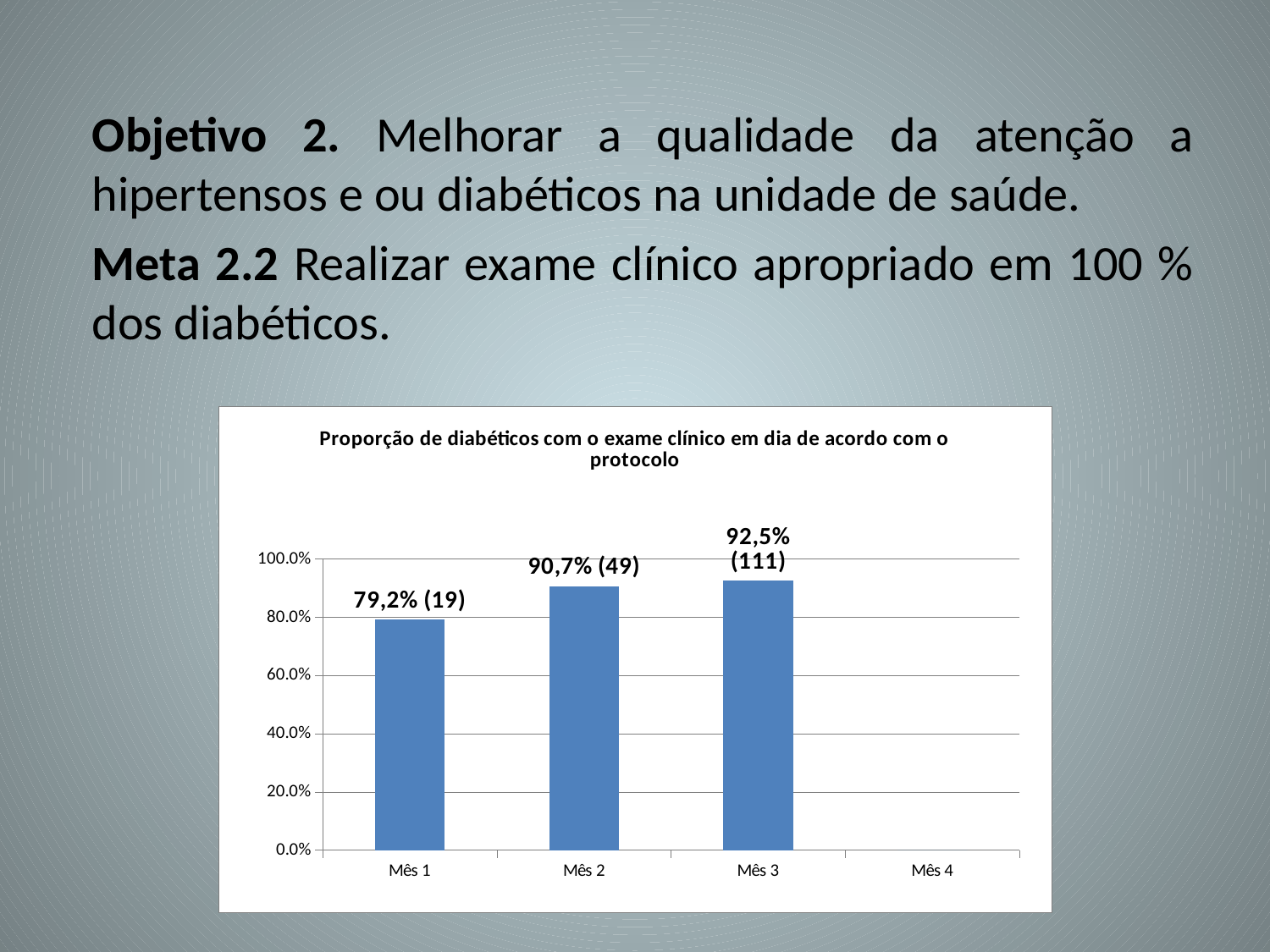
Which month has the highest proportion? Mês 3 Is the value for Mês 1 greater or less than 80.0%? less How many month categories are shown on the x axis? 4 What is the difference in percentage points between Mês 2 and Mês 1? 11,5 What is the title of the chart? Proporção de diabéticos com o exame clínico em dia de acordo com o protocolo Which month with a plotted bar has the lowest proportion? Mês 1 What is the value shown for Mês 1? 79,2% (19) What is the value shown for Mês 2? 90,7% (49) What kind of chart is shown on the slide? bar chart What is the value shown for Mês 3? 92,5% (111) Which is larger, the value for Mês 1 or the value for Mês 2? Mês 2 Do the values rise or fall from Mês 1 to Mês 3? rise